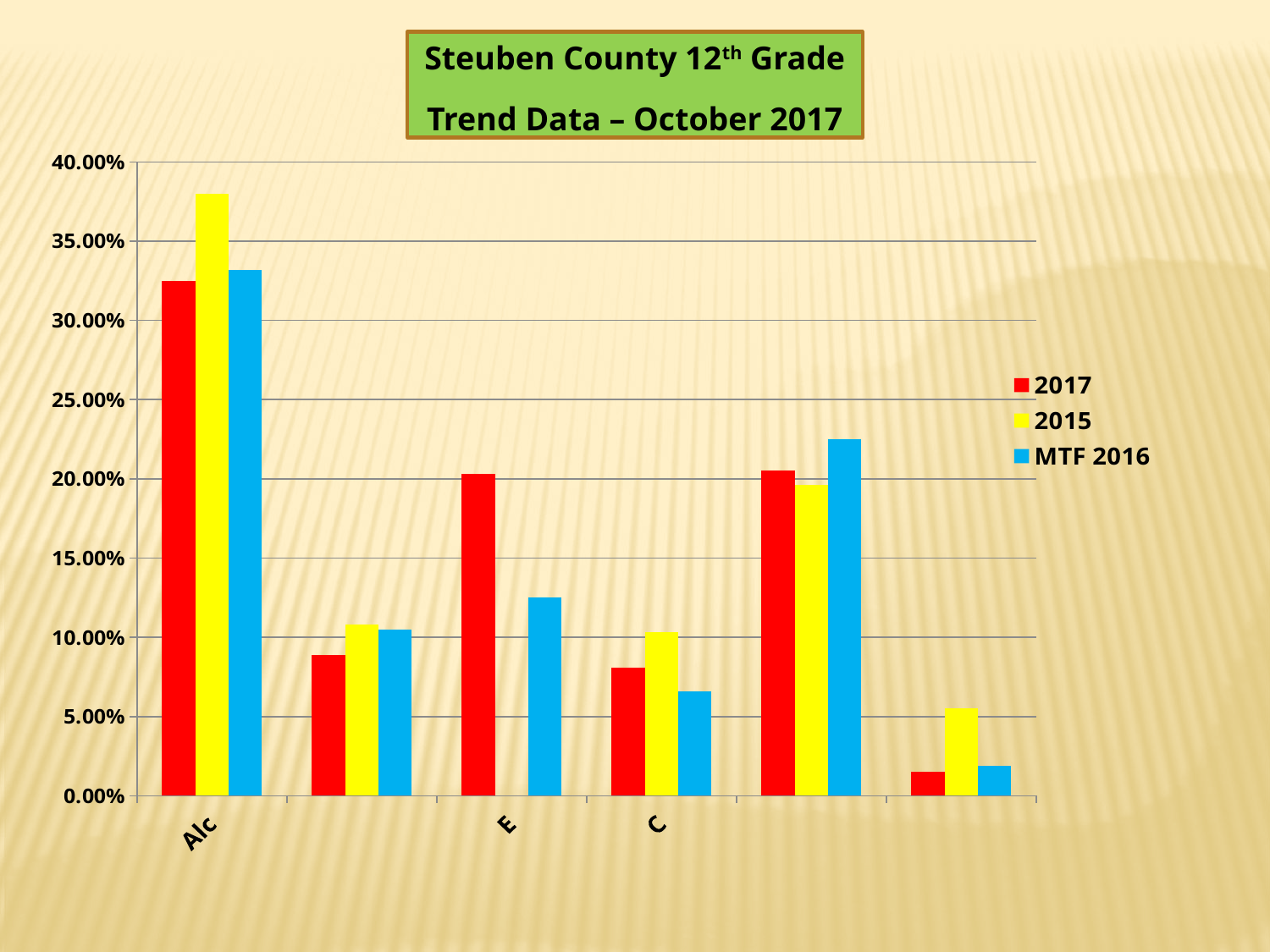
Is the 2017 value for Alc greater or less than 35.00%? less What kind of chart is shown on the slide? bar chart How many series does the legend list? 3 Is the 2015 value for Alc greater or less than 35.00%? greater Which category has the highest 2015 value? Alc For E, which is larger: the 2017 value or the MTF 2016 value? 2017 Is the MTF 2016 value for E greater or less than 15.00%? less For C, which series has the lowest value? MTF 2016 How many category groups of bars are plotted on the chart? 6 For Alc, which is larger: the 2015 value or the 2017 value? 2015 What colour are the bars for the 2017 series? red